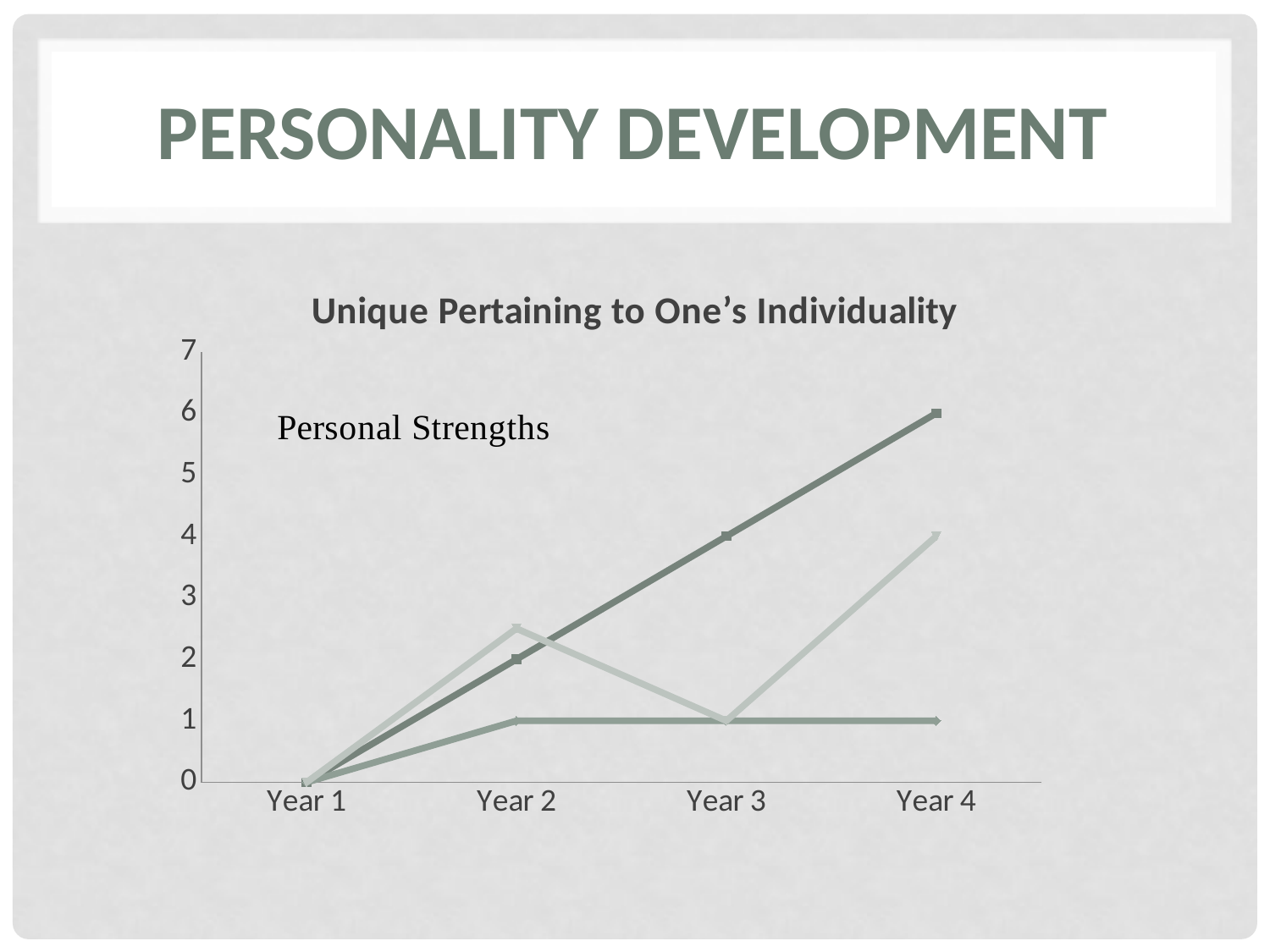
What text label appears inside the plot area of the chart? Personal Strengths What value does the medium green line have at Year 4? 1 How many lines are plotted on the chart? 3 Does the dark green line rise or fall from Year 1 to Year 4? rise What is the title of the chart? Unique Pertaining to One’s Individuality What value does the dark green line reach at Year 4? 6 What value does the light grey line reach at Year 4? 4 Is the value of the light grey line at Year 2 greater or less than 2? greater At Year 4, which line is higher: the dark green line or the light grey line? the dark green line What value does the dark green line have at Year 3? 4 How many categories are shown on the x axis of the chart? 4 What kind of chart is shown on the slide? line chart